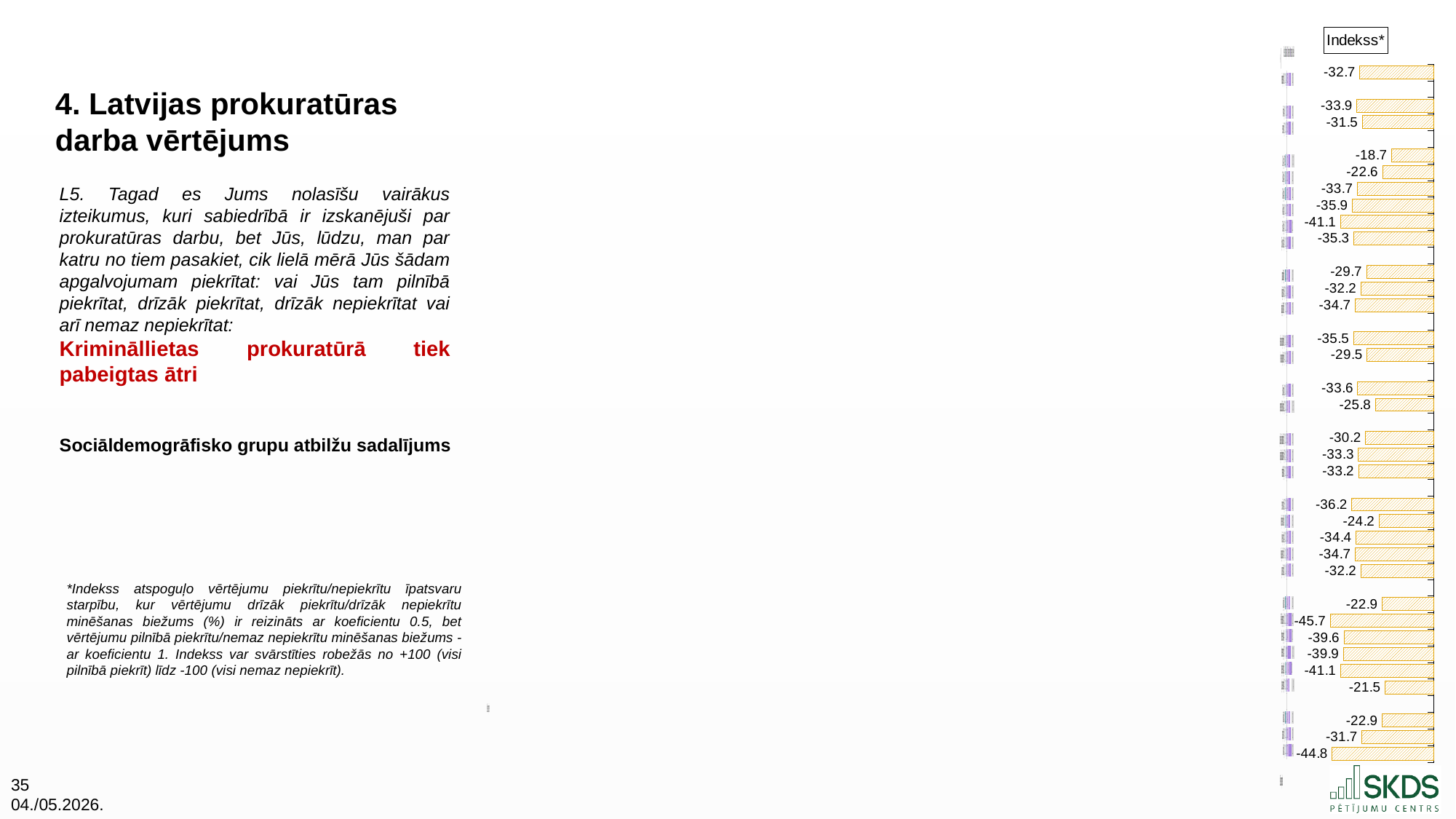
Are the index values in the chart positive or negative? negative What is the heading printed above the chart on the right? Indekss* Which is larger, the topmost bar's value of -32.7 or the bottommost bar's value of -44.8? -32.7 What kind of chart is shown on the right side of the slide? bar chart What is the lowest index value shown in the chart? -45.7 What is the highest (closest to zero) index value shown in the chart? -18.7 How many bars with data labels are shown in the chart? 33 What is the difference between the highest index value (-18.7) and the lowest index value (-45.7) in the chart? 27.0 What is the index value of the bottommost bar in the chart? -44.8 Which statement (in red) is the chart's index evaluating? Kriminālietas prokuratūrā tiek pabeigtas ātri What is the index value of the topmost bar in the chart? -32.7